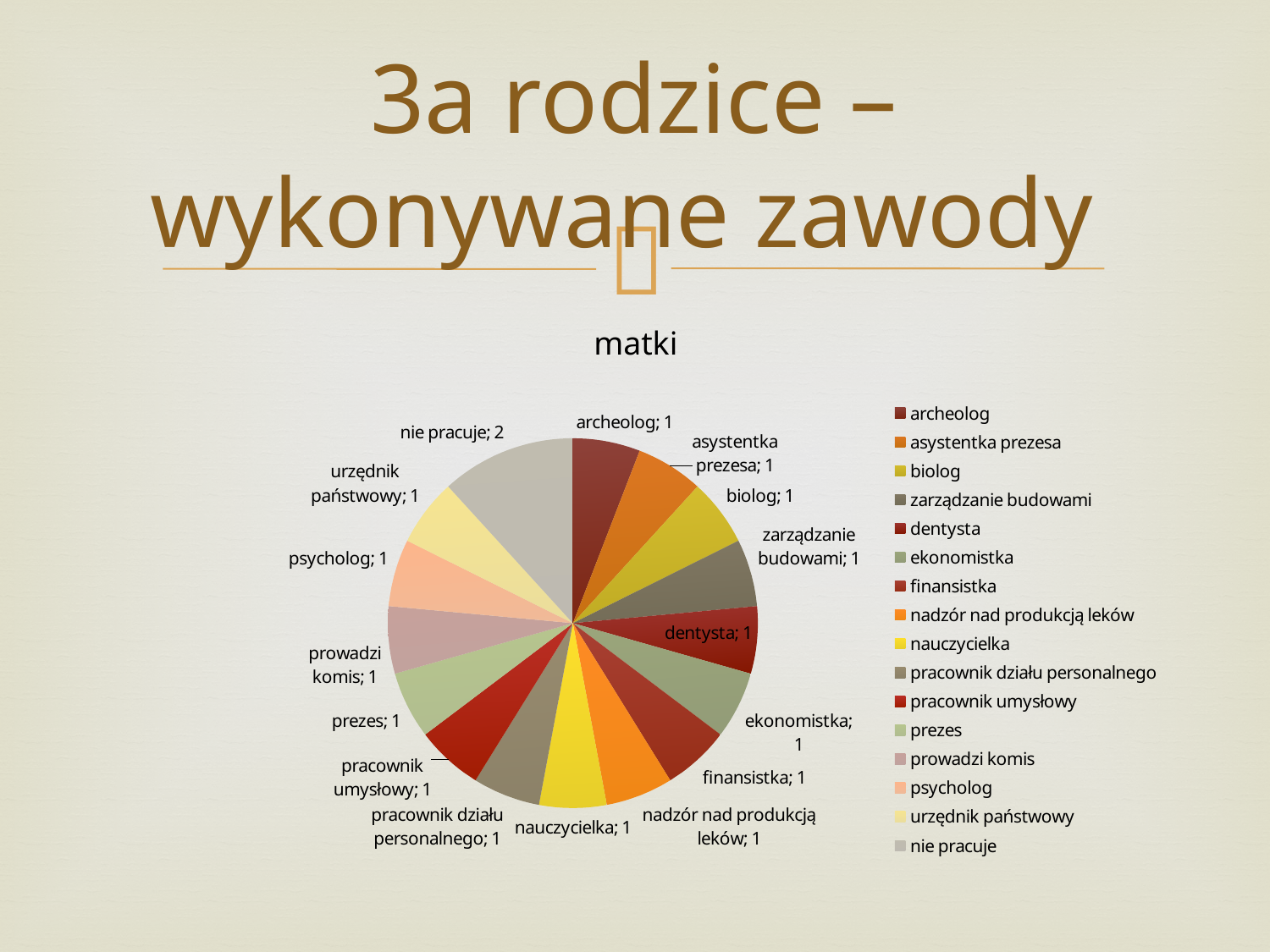
How many entries does the legend list? 16 What is the value for "nadzór nad produkcją leków"? 1 What is the value for "nie pracuje"? 2 What is the value for "urzędnik państwowy"? 1 Which is larger, the value for "nie pracuje" or the value for "psycholog"? nie pracuje What is the total of all the values in the pie chart? 17 What is the value for "dentysta"? 1 What kind of chart is shown on the slide? pie chart Which category has the largest slice? nie pracuje What is the difference between the value for "nie pracuje" and the value for "archeolog"? 1 What is the title of the chart? matki How many categories does the pie chart have? 16